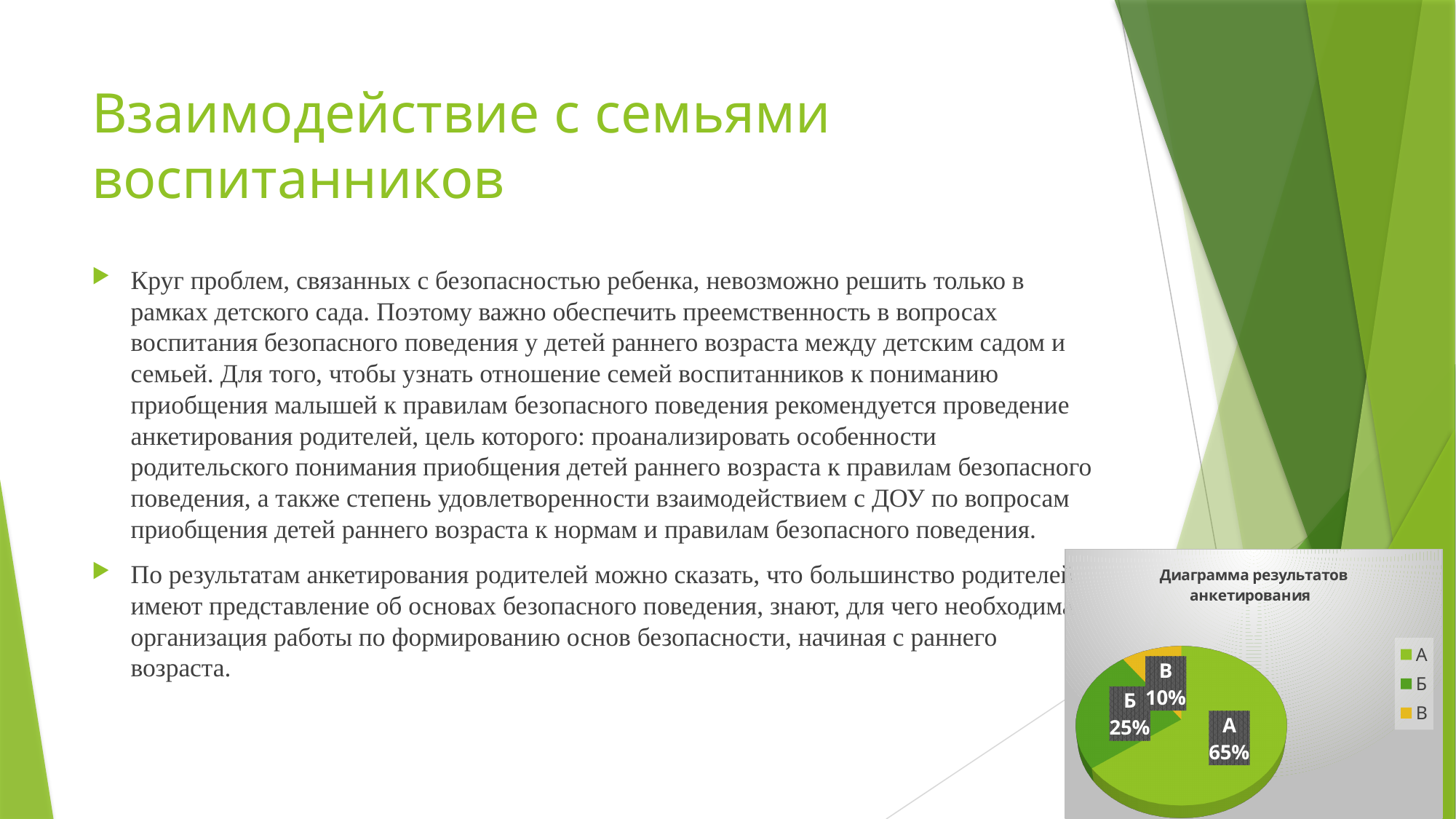
How many slices does the pie chart have? 3 What percentage does slice В represent in the pie chart? 10% What percentage does slice Б represent in the pie chart? 25% What is the difference in percentage points between slice Б and slice В? 15 How many entries does the chart legend list? 3 Which is larger in the pie chart, slice Б or slice В? Б Which slice of the pie chart is the smallest? В What is the difference in percentage points between slice А and slice Б? 40 Which slice of the pie chart is the largest? А What percentage does slice А represent in the pie chart? 65% What is the title of the chart on the slide? Диаграмма результатов анкетирования What type of chart is shown on the slide? pie chart